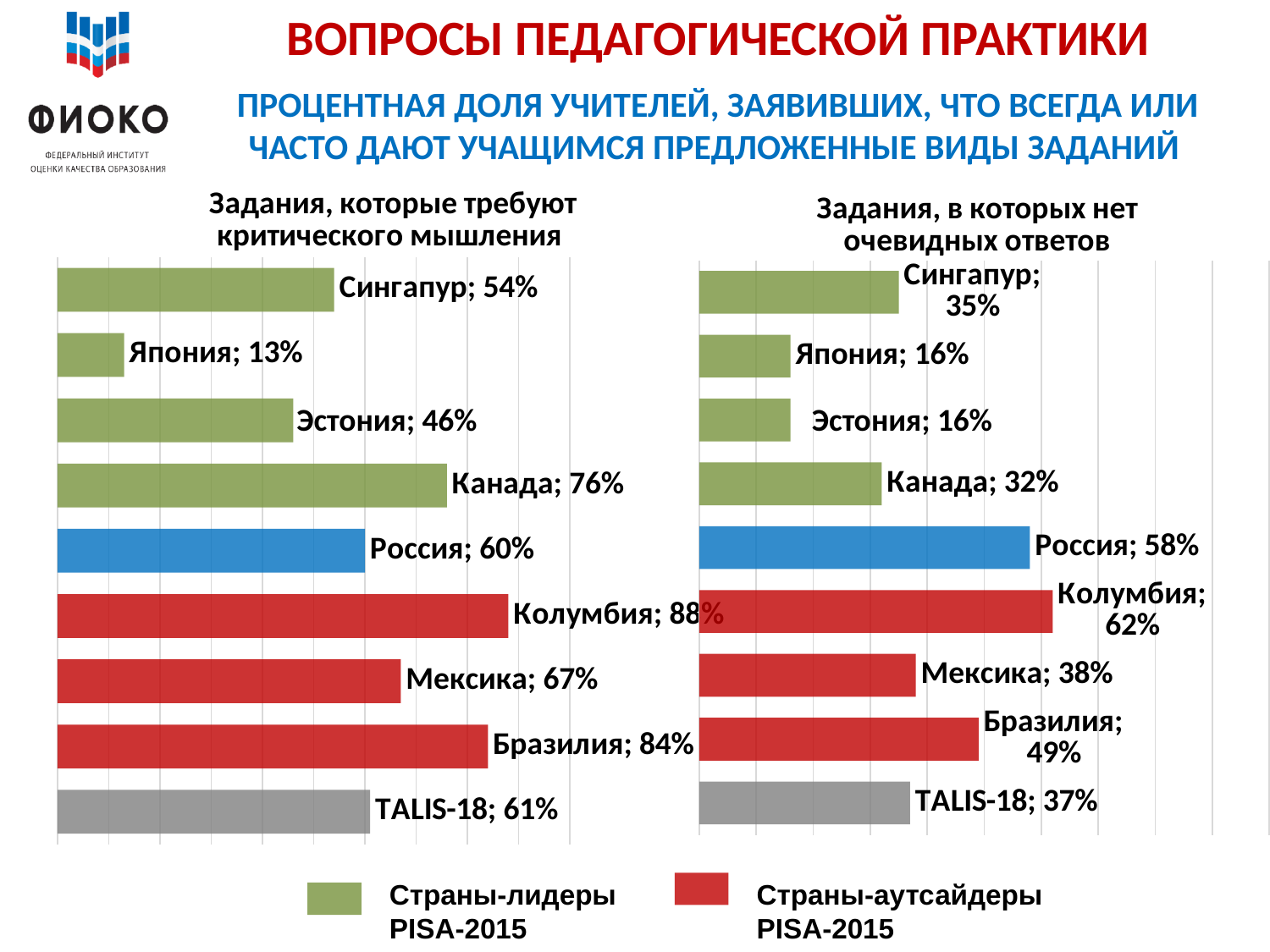
In the chart 'Задания, в которых нет очевидных ответов', which category has the lowest value? Япония and Эстония (16%) What colour are the bars for Россия in both charts? Blue In the chart 'Задания, которые требуют критического мышления', which country has the highest value? Колумбия How many entries does the legend at the bottom of the slide list? 2 In the chart 'Задания, в которых нет очевидных ответов', which is larger: Сингапур or Канада? Сингапур In the chart 'Задания, в которых нет очевидных ответов', what is the value for Россия? 58% In the chart 'Задания, которые требуют критического мышления', what is the difference between Россия and TALIS-18? 1% In the chart 'Задания, которые требуют критического мышления', what is the difference between Бразилия and Мексика? 17% What type of chart is used on this slide? Bar chart In the chart 'Задания, которые требуют критического мышления', what is the value for Канада? 76% How many bars are shown in the chart 'Задания, которые требуют критического мышления'? 9 In the chart 'Задания, в которых нет очевидных ответов', what is the value for TALIS-18? 37%